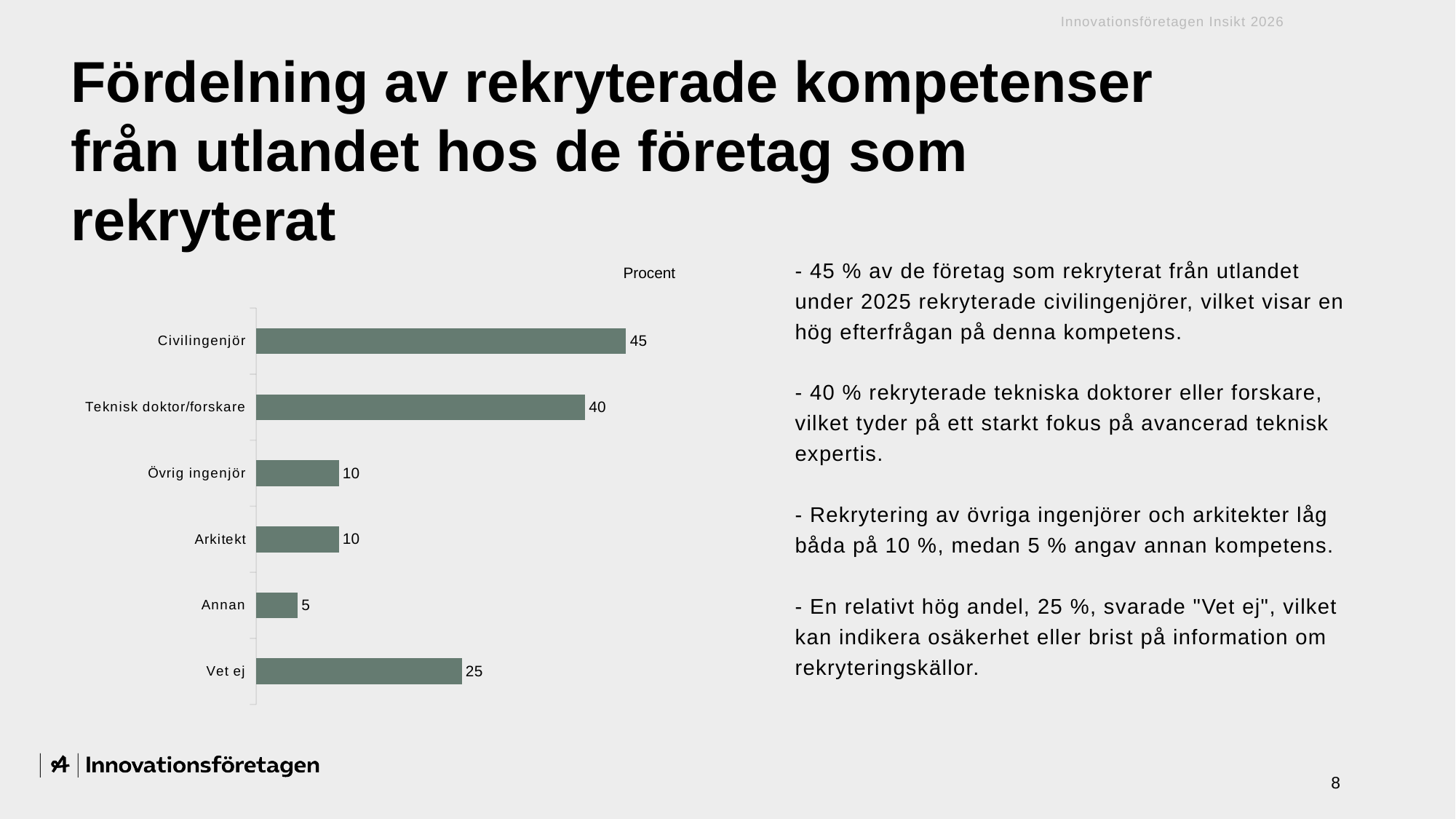
What is the value for Teknisk doktor/forskare? 40 What is the value for Annan? 5 What is the value for Civilingenjör? 45 What unit label is shown above the chart? Procent What kind of chart is shown on the slide? Bar chart Which category has the lowest value? Annan What is the difference between the values for Vet ej and Annan? 20 Which is larger, the value for Vet ej or the value for Arkitekt? Vet ej What is the difference between the values for Civilingenjör and Teknisk doktor/forskare? 5 Which category has the highest value? Civilingenjör How many categories are shown in the chart? 6 What is the value for Vet ej? 25